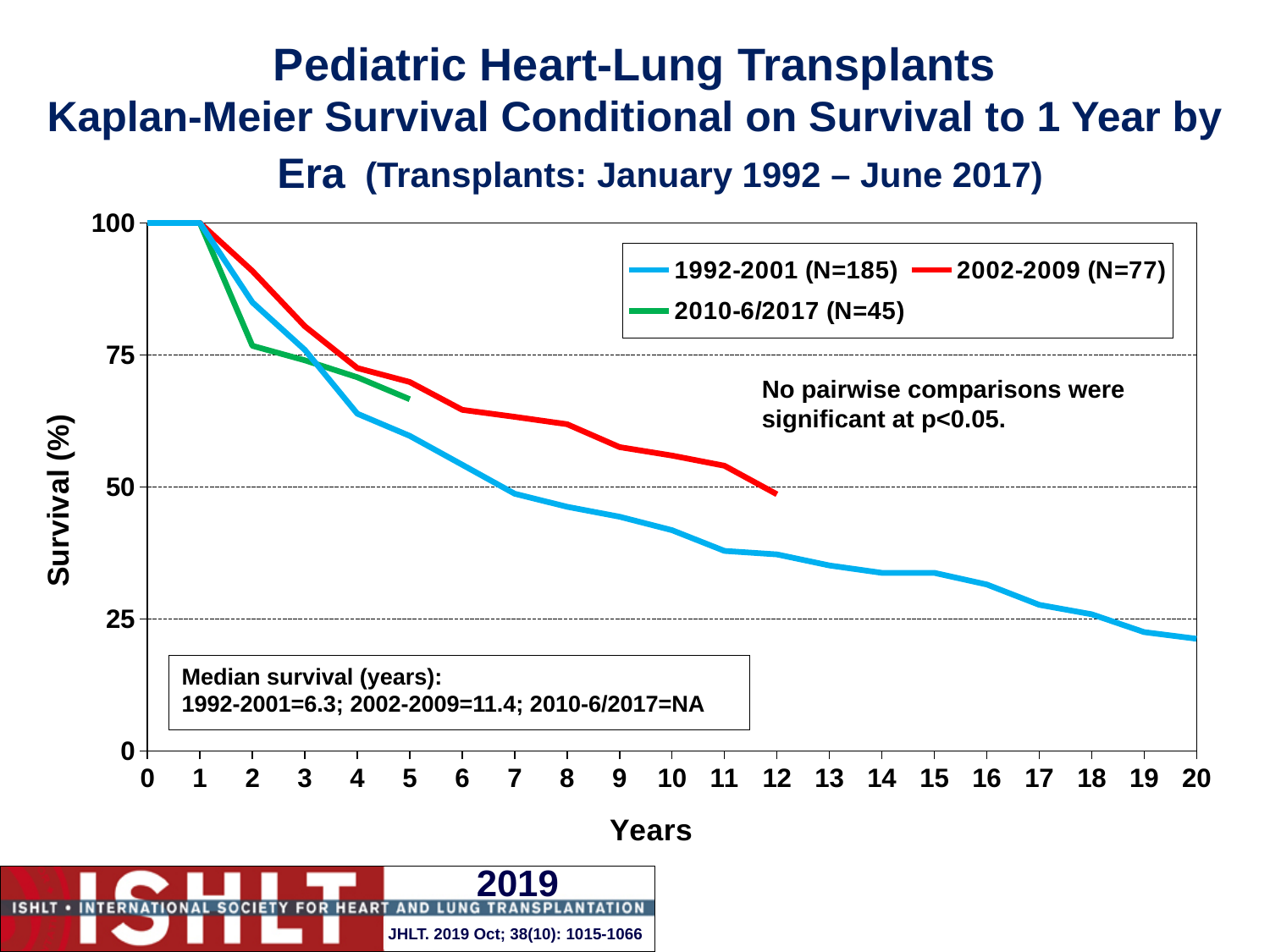
Is the survival value for the 2002-2009 era at 8 years greater or less than 50? greater Which era has the longest median survival among those with a value given? 2002-2009 Which era has the largest number of transplants (N) according to the legend? 1992-2001 (N=185) What is the median survival given for the 2010-6/2017 era? NA At 10 years, which era has higher survival: 1992-2001 or 2002-2009? 2002-2009 What is the N for the 2010-6/2017 era shown in the legend? 45 Is the survival value for the 1992-2001 era at 10 years greater or less than 50? less How many series does the legend list? 3 What is the median survival in years for the 2002-2009 era? 11.4 Do the survival curves rise or fall as years increase? fall What kind of chart is shown on the slide? line chart What is the median survival in years for the 1992-2001 era? 6.3